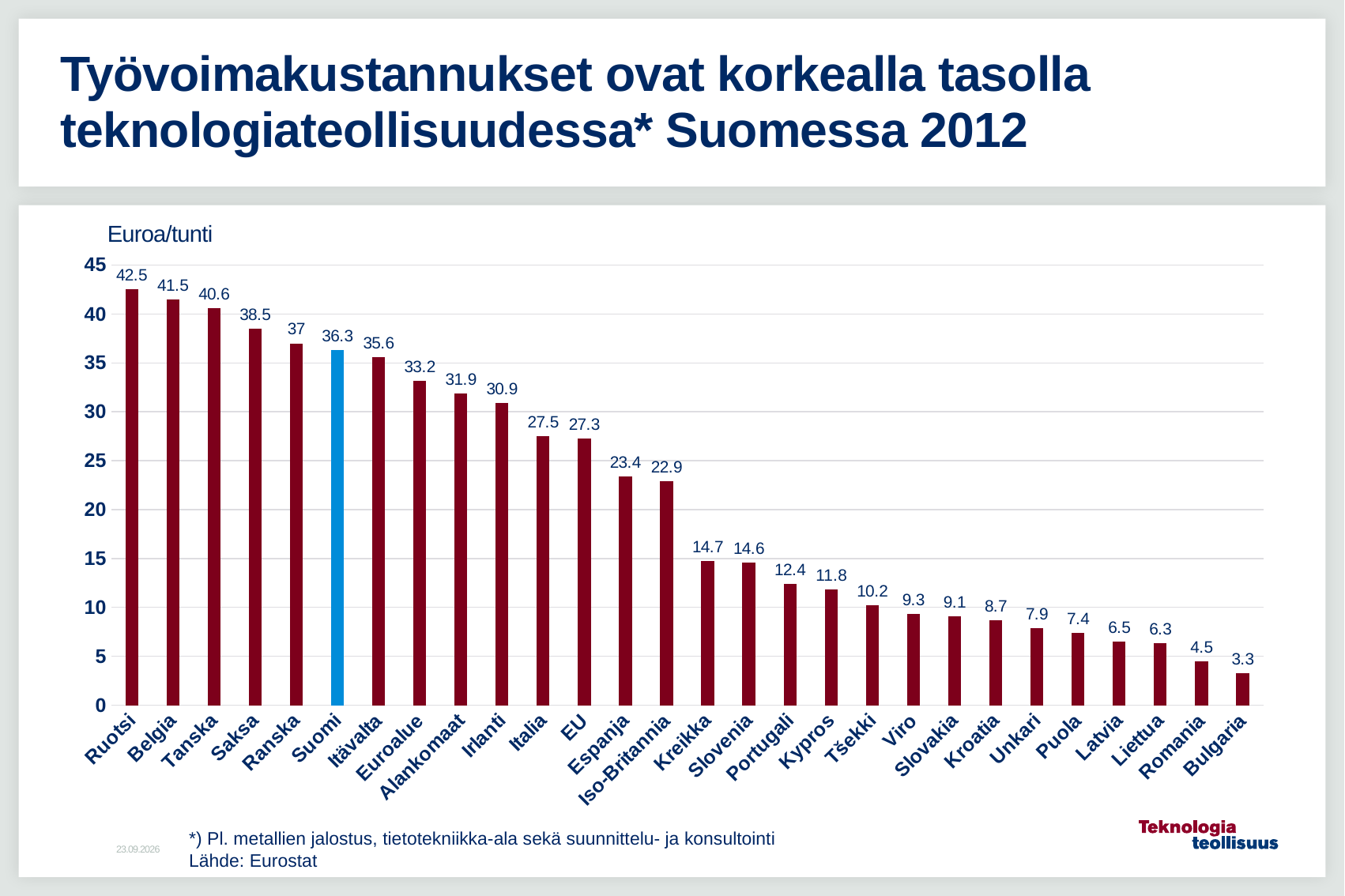
What is the value for Viro? 9.3 Which has a larger value, Belgia or Tanska? Belgia Which country has the lowest value? Bulgaria What is the value for Saksa? 38.5 What is the difference between the values for Ruotsi and Suomi? 6.2 What kind of chart is shown on the slide? Bar chart What is the value for Suomi? 36.3 Which country has the highest value? Ruotsi What is the difference between the values for Euroalue and EU? 5.9 What unit is shown above the vertical axis? Euroa/tunti How many countries or regions are shown on the chart? 28 What is the value for Iso-Britannia? 22.9